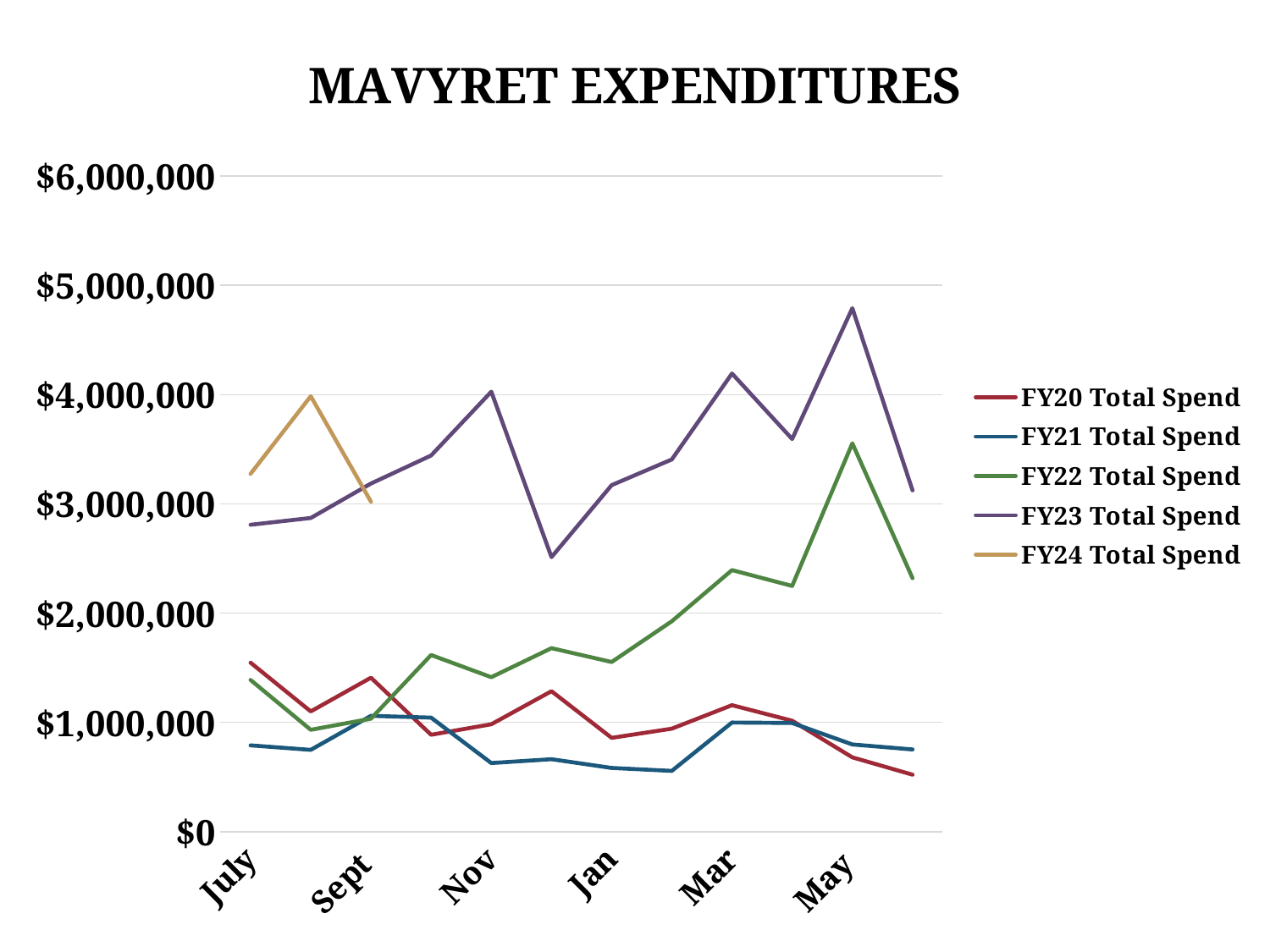
Is the value for FY23 Total Spend at July greater or less than $3,000,000? less Is the value for FY24 Total Spend at July greater or less than $3,000,000? greater What kind of chart is shown on the slide? line chart How many series does the legend list? 5 Does FY22 Total Spend rise or fall from Jan to Mar? rise Is the value for FY23 Total Spend at Mar greater or less than $4,000,000? greater Which series has the lowest value at July? FY21 Total Spend How many month labels are shown on the x axis? 6 What is the title of the chart? MAVYRET EXPENDITURES Which series reaches the highest value on the chart? FY23 Total Spend At Mar, which is larger: FY23 Total Spend or FY22 Total Spend? FY23 Total Spend